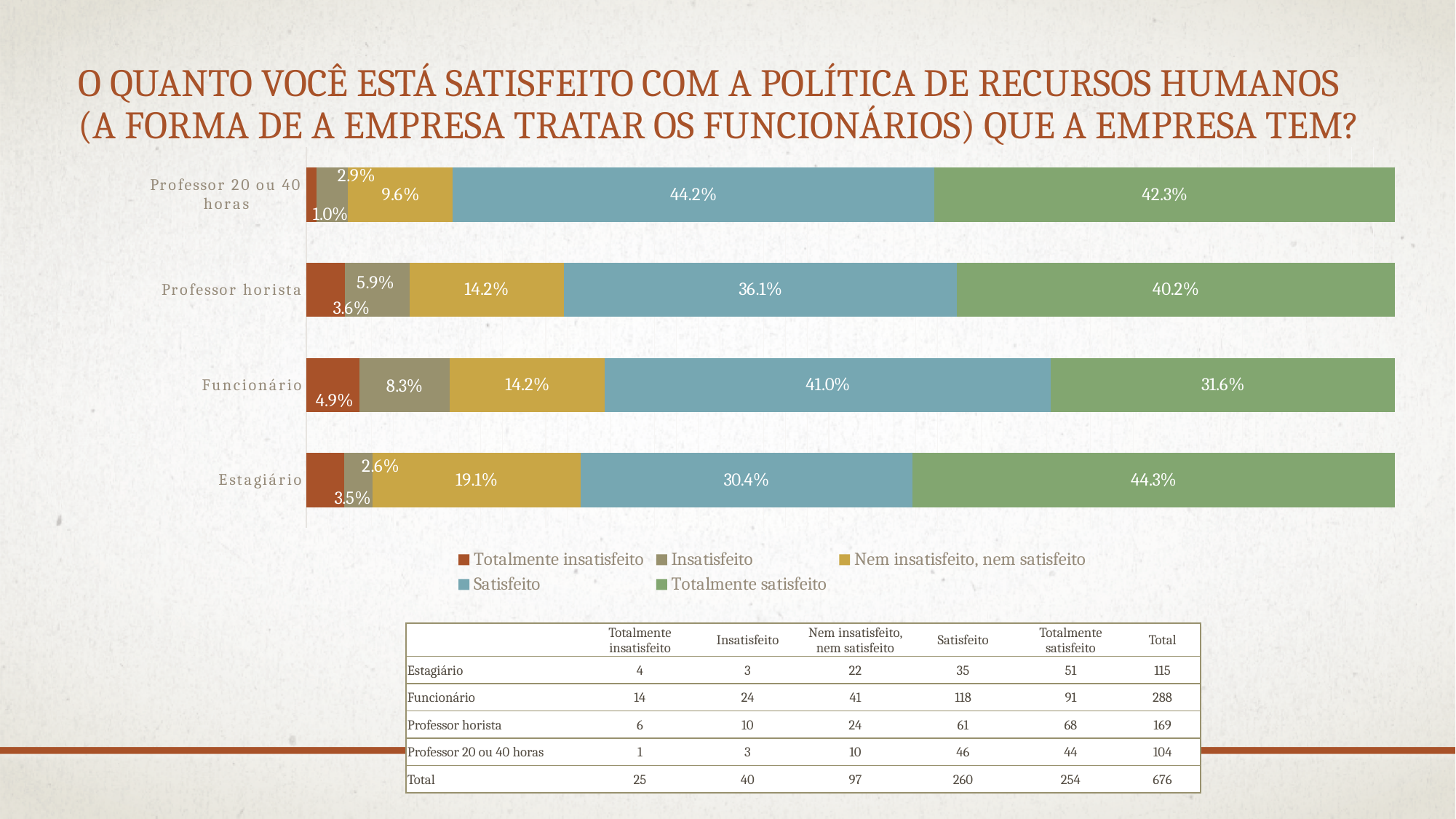
Which category has the highest Satisfeito value? Professor 20 ou 40 horas What kind of chart is shown on the slide? Stacked bar chart Which has a larger Satisfeito value, Professor horista or Estagiário? Professor horista What is the value for Satisfeito in the Funcionário bar? 41.0% What is the value for Insatisfeito in the Professor horista bar? 5.9% How many series does the legend list? 5 How many categories (bars) are shown in the chart? 4 Which category has the lowest Totalmente insatisfeito value? Professor 20 ou 40 horas What is the difference between the Nem insatisfeito, nem satisfeito values for Estagiário and Professor 20 ou 40 horas? 9.5 percentage points Which colour represents Satisfeito in the legend? Blue Which category has the highest Totalmente satisfeito value? Estagiário What is the value for Totalmente satisfeito in the Estagiário bar? 44.3%